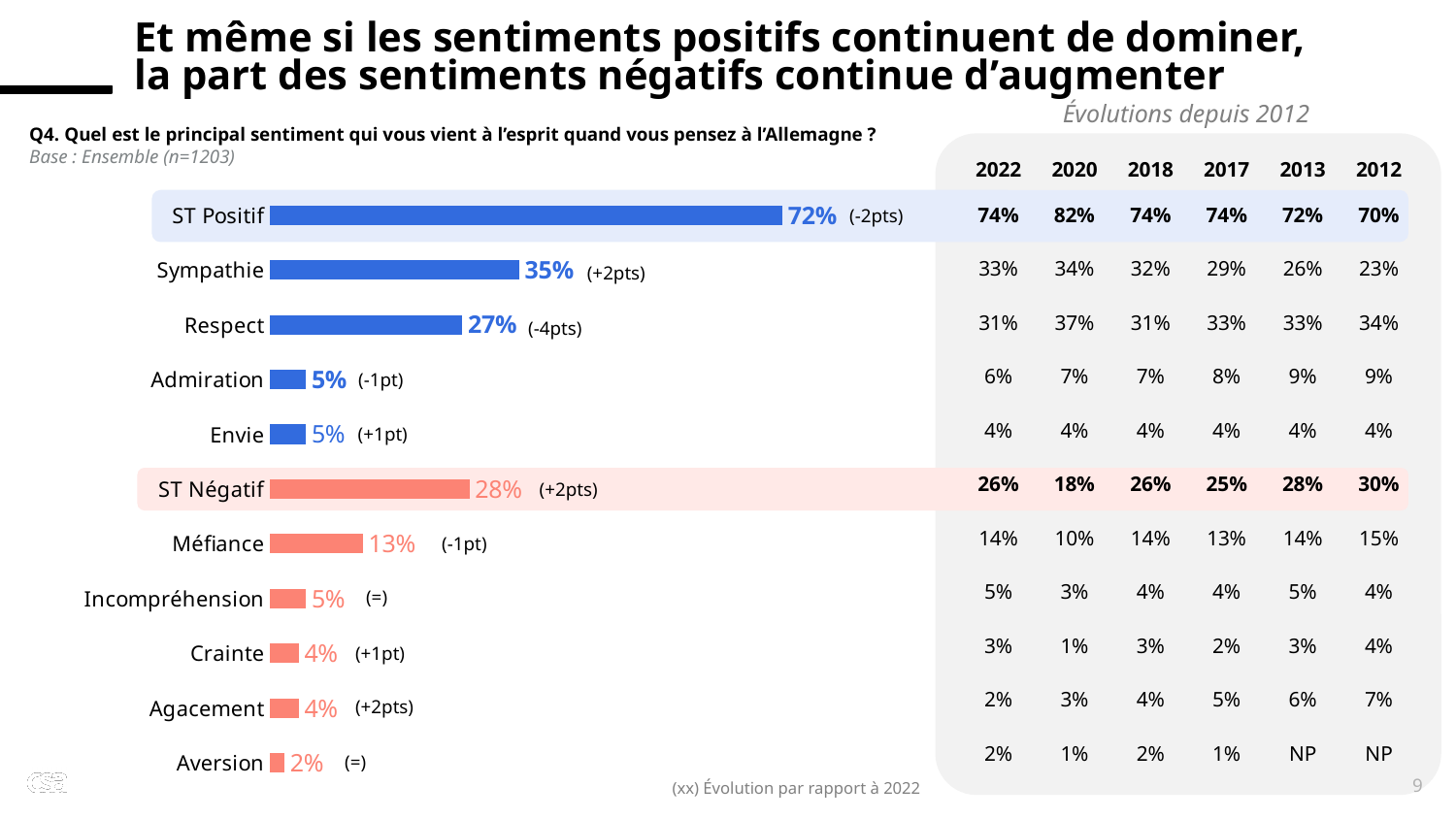
Which category has the highest value in the bar chart? ST Positif What is the value shown for ST Négatif in the bar chart? 28% What is the difference between the values for ST Positif and ST Négatif in the bar chart? 44 points What kind of chart is shown on the slide? Bar chart Which category has the lowest value in the bar chart? Aversion What is the difference between the values for Sympathie and Respect in the bar chart? 8 points Which is larger in the bar chart, the value for Méfiance or the value for Incompréhension? Méfiance What is the value shown for Méfiance in the bar chart? 13% What change compared to 2022 is indicated next to the ST Positif bar? -2pts How many categories are shown in the bar chart? 11 What is the value shown for Sympathie in the bar chart? 35% What is the value shown for Respect in the bar chart? 27%